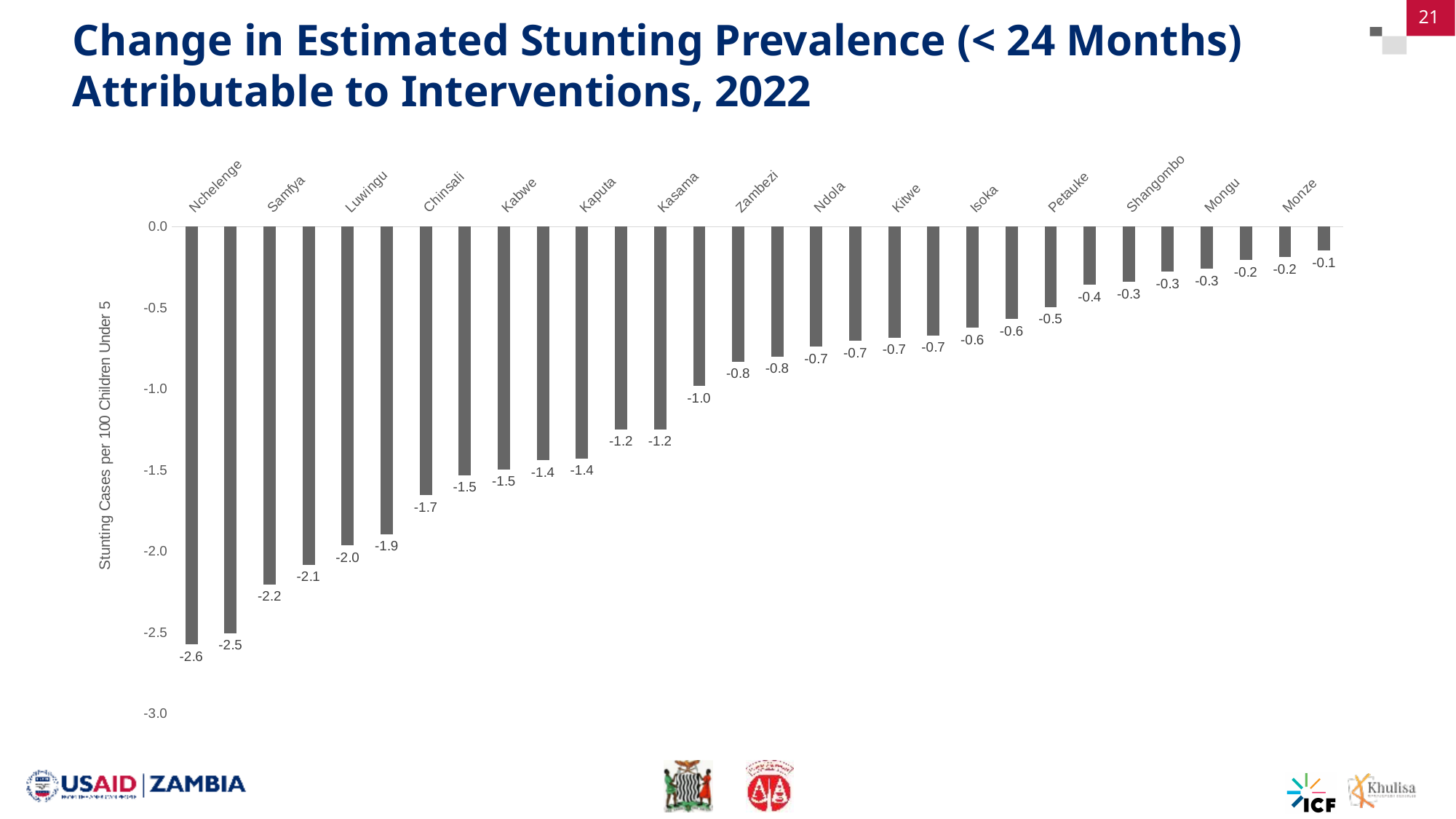
What is the value for Zambezi? -0.8 What is the value for Nchelenge? -2.6 Which labelled district has the lowest (most negative) value? Nchelenge What is the value for Chinsali? -1.7 How many bars are plotted in the chart? 30 What is the difference between the values for Nchelenge and Samfya? 0.4 What is the value for Luwingu? -2.0 What is the value for Samfya? -2.2 What type of chart is shown on the slide? bar chart Do the bar values rise or fall moving from left to right along the x axis? rise Which has the larger reduction in stunting cases, Nchelenge or Petauke? Nchelenge What is the value for Petauke? -0.5